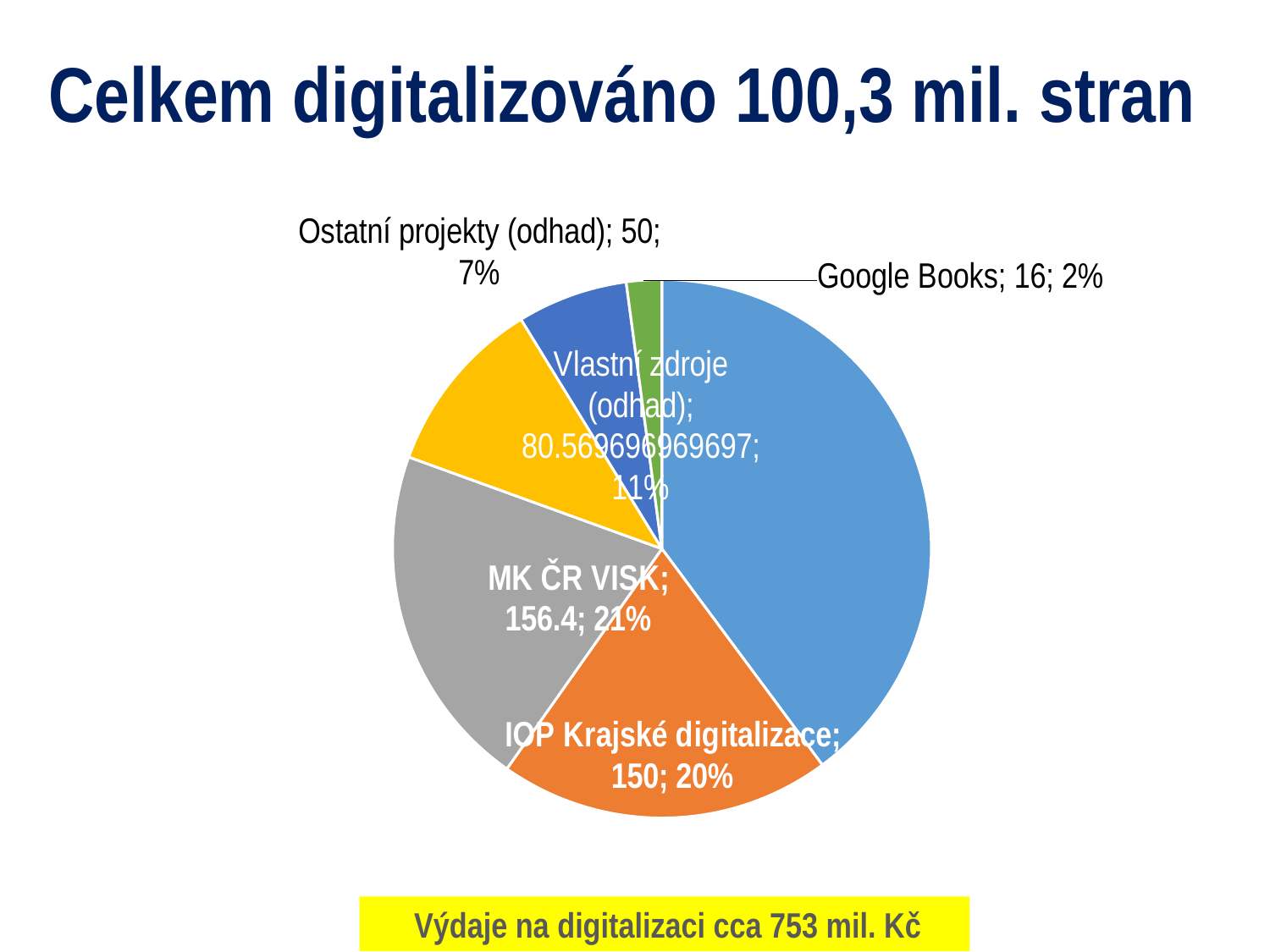
Which slice is the smallest in the pie chart? Google Books Which is larger, MK ČR VISK or IOP Krajské digitalizace? MK ČR VISK What share of the pie does MK ČR VISK represent? 21% What is the difference between the values for MK ČR VISK and IOP Krajské digitalizace? 6.4 What value is shown for Google Books? 16 What share of the pie does Google Books represent? 2% What value is shown for MK ČR VISK? 156.4 What value is shown for IOP Krajské digitalizace? 150 What is the title of the slide above the pie chart? Celkem digitalizováno 100,3 mil. stran What value is shown for Ostatní projekty (odhad)? 50 What kind of chart is shown on the slide? pie chart What share of the pie does Ostatní projekty (odhad) represent? 7%